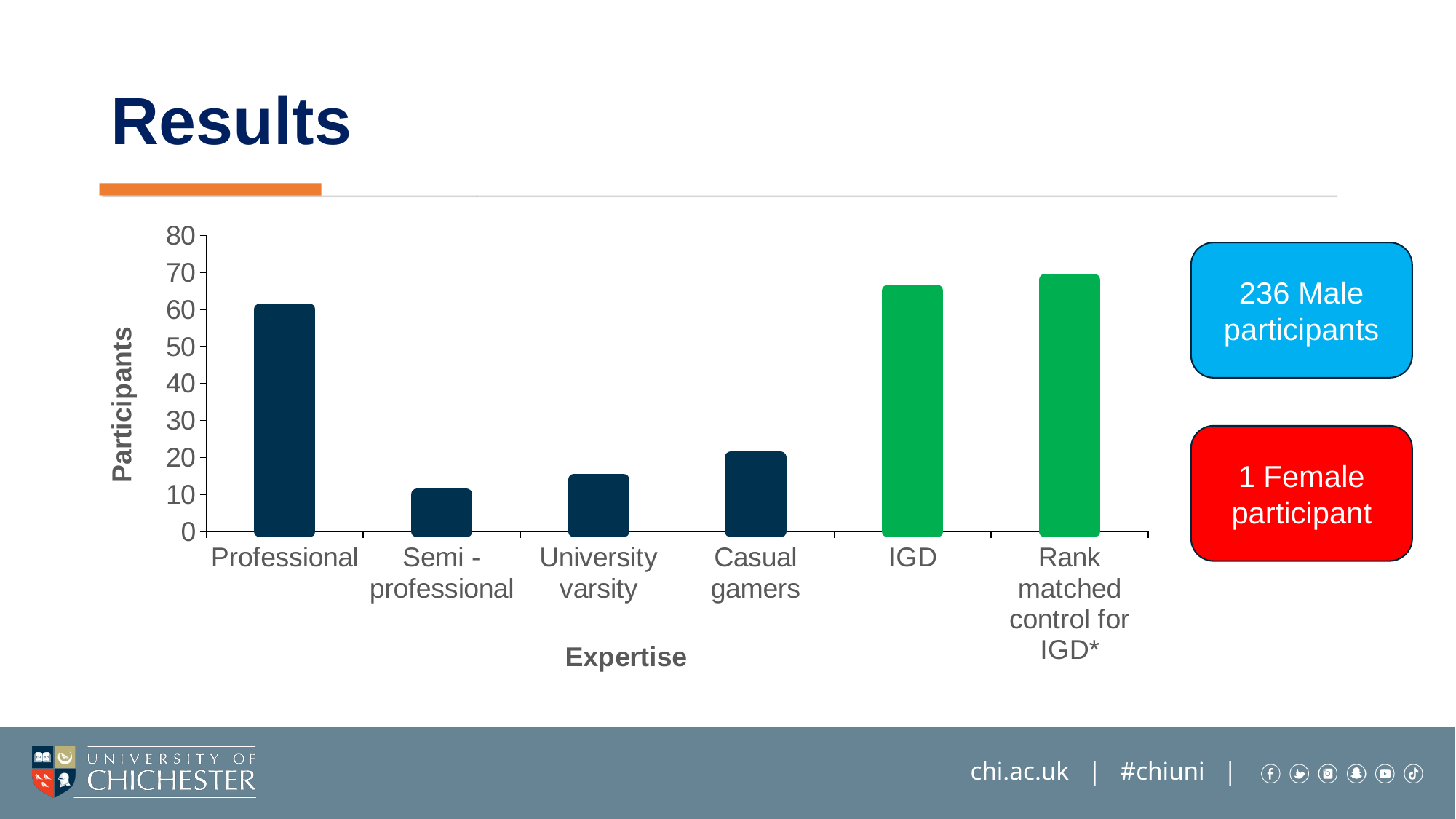
What kind of chart is shown on the slide? bar chart Which category has the lowest number of participants? Semi - professional Is the value for IGD greater or less than 60? greater Is the value for University varsity greater or less than 20? less Is the value for Semi - professional greater or less than 20? less Which has more participants, Professional or Casual gamers? Professional What is the label on the vertical axis of the chart? Participants How many expertise categories are shown on the x axis of the chart? 6 What is the label on the horizontal axis of the chart? Expertise